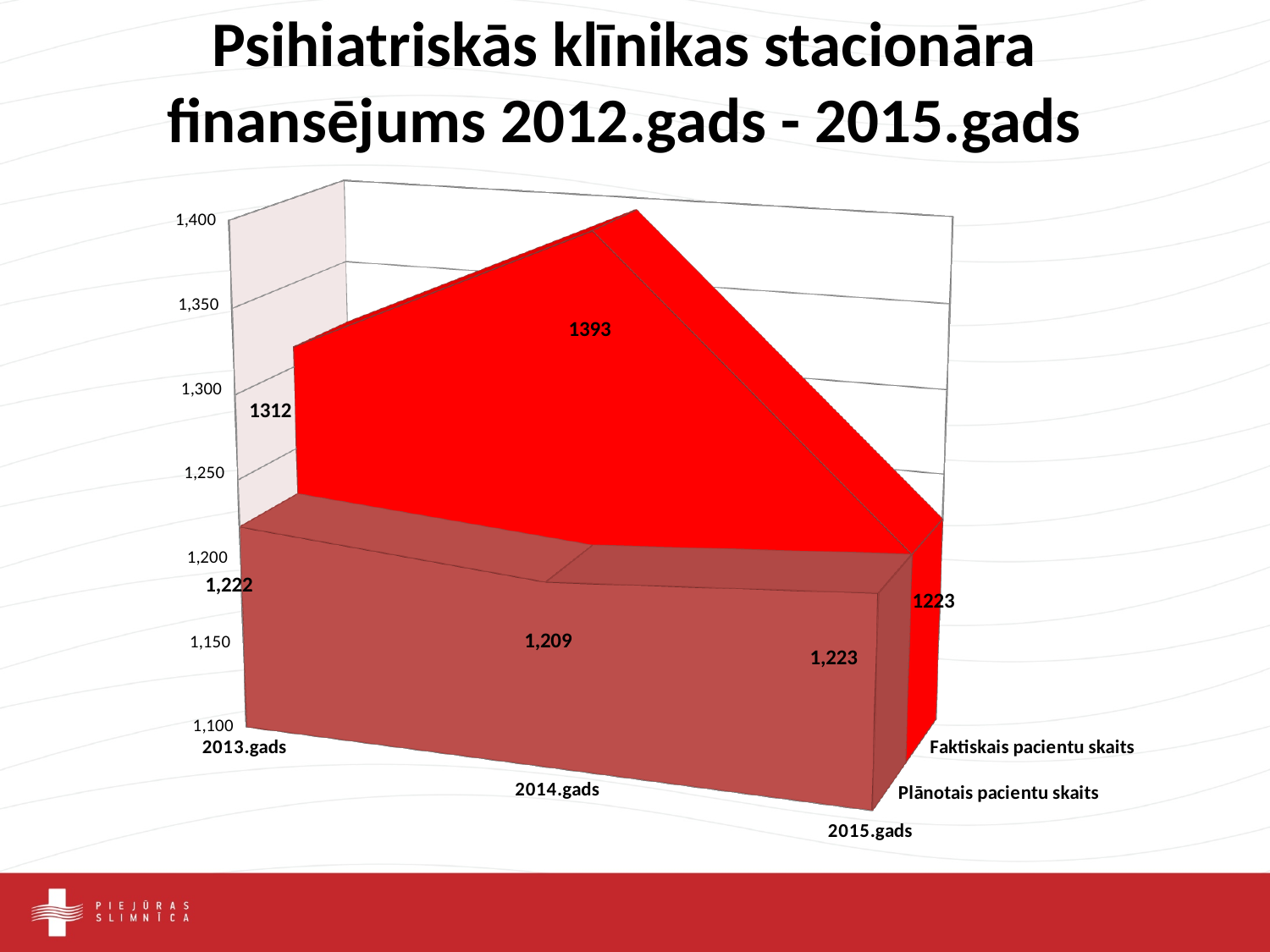
By how much did Faktiskais pacientu skaits increase from 2013.gads to 2014.gads? 81 Which is larger in 2013.gads: Faktiskais pacientu skaits or Plānotais pacientu skaits? Faktiskais pacientu skaits In which year is Plānotais pacientu skaits lowest? 2014.gads What is the value of Plānotais pacientu skaits for 2014.gads? 1,209 What is the difference between Faktiskais pacientu skaits and Plānotais pacientu skaits in 2014.gads? 184 What is the value of Faktiskais pacientu skaits for 2014.gads? 1393 How many data series does the chart show? 2 What kind of chart is shown on the slide? 3D area chart How many years are shown on the x axis? 3 What is the value of Faktiskais pacientu skaits for 2013.gads? 1312 What is the value of Plānotais pacientu skaits for 2015.gads? 1,223 In which year is Faktiskais pacientu skaits highest? 2014.gads